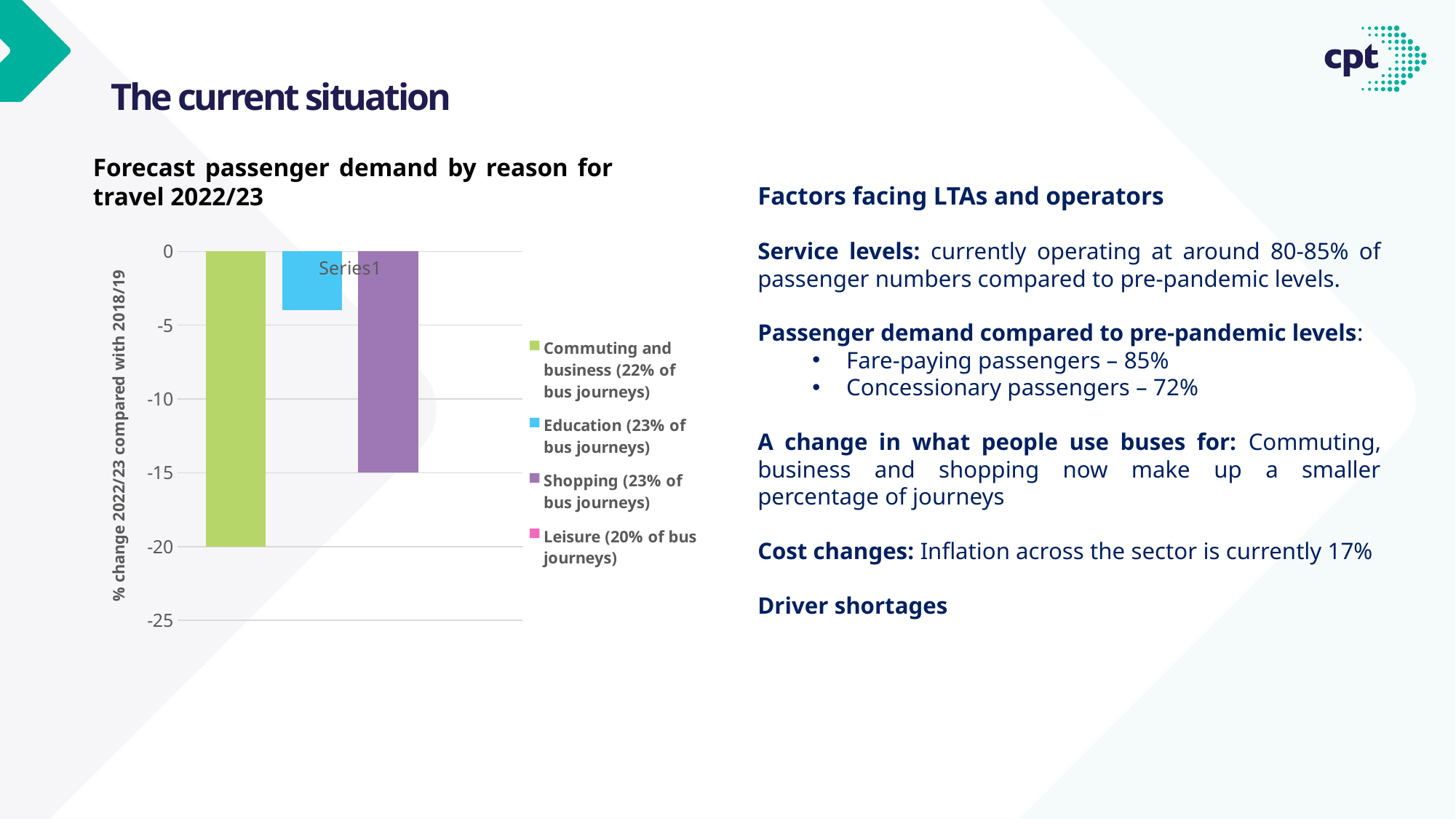
Which bar extends further below zero, Education or Shopping? Shopping What kind of chart is shown on the slide? bar chart How many categories does the chart's legend list? 4 What is the label on the chart's vertical axis? % change 2022/23 compared with 2018/19 Is the value for Education greater or less than -5? greater What is the title of the chart? Forecast passenger demand by reason for travel 2022/23 How many bars are visibly plotted in the chart? 3 Which category has the lowest (most negative) value in the chart? Commuting and business What is the % change for Shopping in the chart? -15 What is the difference between the values for Commuting and business and Shopping? 5 What is the % change for Commuting and business in the chart? -20